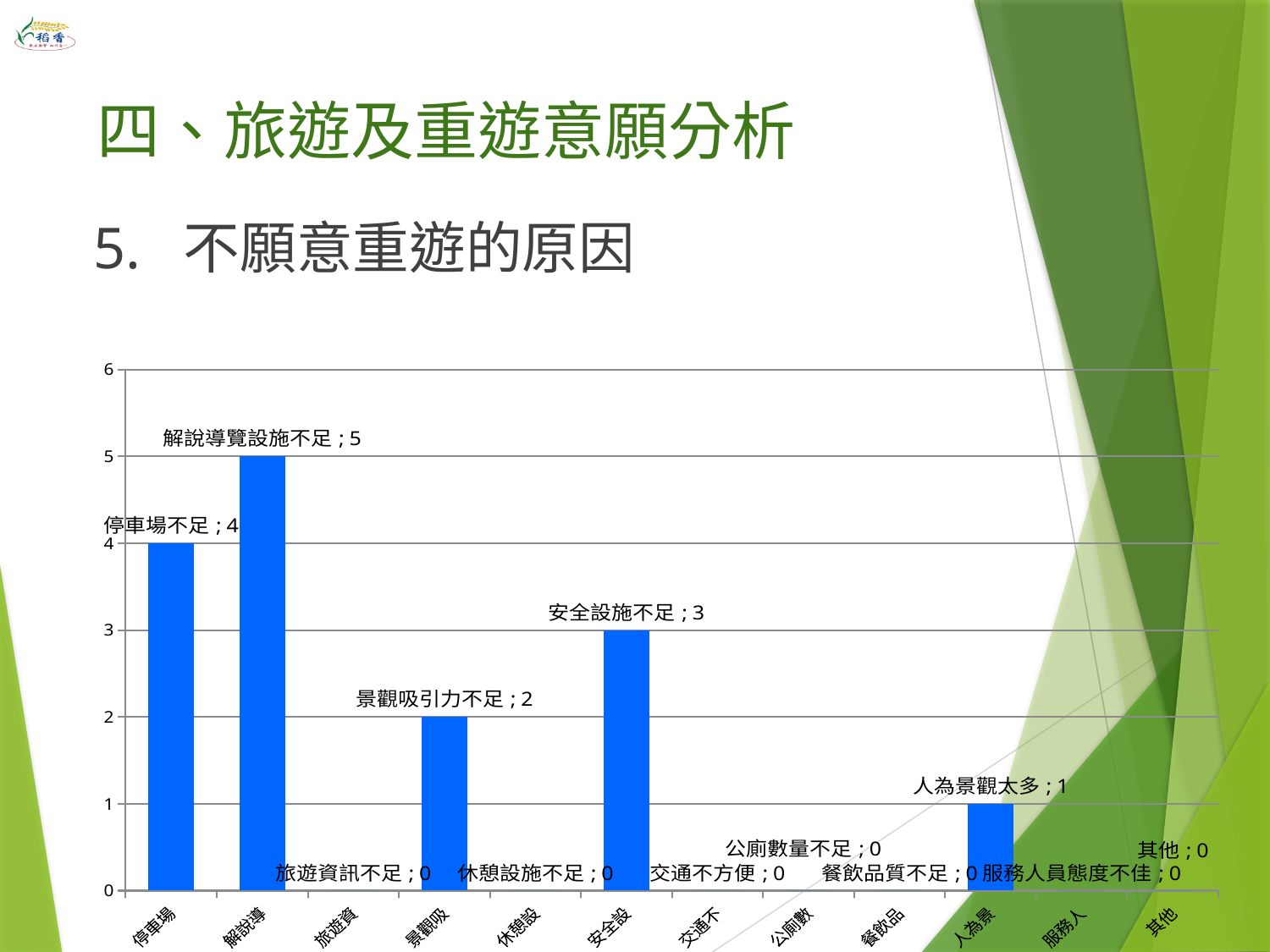
What is the value for 解說導覽設施不足? 5 What is the difference between the values for 停車場不足 and 安全設施不足? 1 What is the value for 人為景觀太多? 1 What is the highest value shown on the vertical axis? 6 What is the value for 交通不方便? 0 What kind of chart is shown on the slide? bar chart How many categories are shown on the x axis? 12 What is the value for 停車場不足? 4 What is the difference between the values for 解說導覽設施不足 and 景觀吸引力不足? 3 What is the value for 安全設施不足? 3 Which category has the highest value? 解說導覽設施不足 Which is larger, the value for 停車場不足 or the value for 安全設施不足? 停車場不足